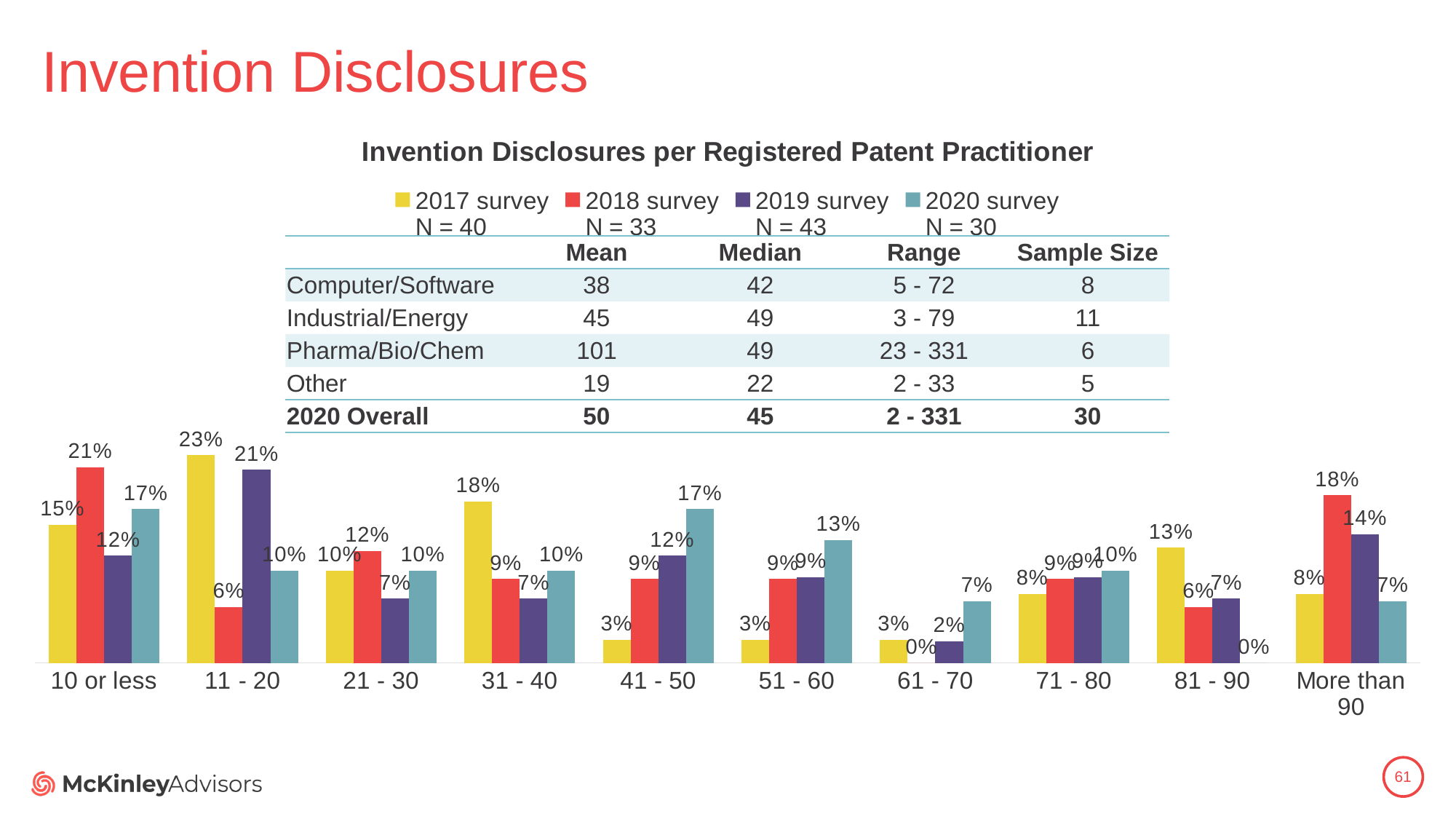
Which category has the highest 2017 survey value? 11 - 20 What is the 2019 survey value for the 'More than 90' category? 14% How many series does the chart legend list? 4 What is the 2018 survey value for the '10 or less' category? 21% Which is larger for the '31 - 40' category: the 2017 survey value or the 2020 survey value? 2017 survey How many categories are shown on the x axis of the chart? 10 What is the 2017 survey value for the '11 - 20' category? 23% What is the 2020 survey value for the '41 - 50' category? 17% What kind of chart is shown on the slide? Bar chart Which category has the lowest 2020 survey value? 81 - 90 What is the sample size (N) for the 2019 survey shown in the legend? 43 What is the difference between the 2017 survey and 2018 survey values for the '11 - 20' category? 17%